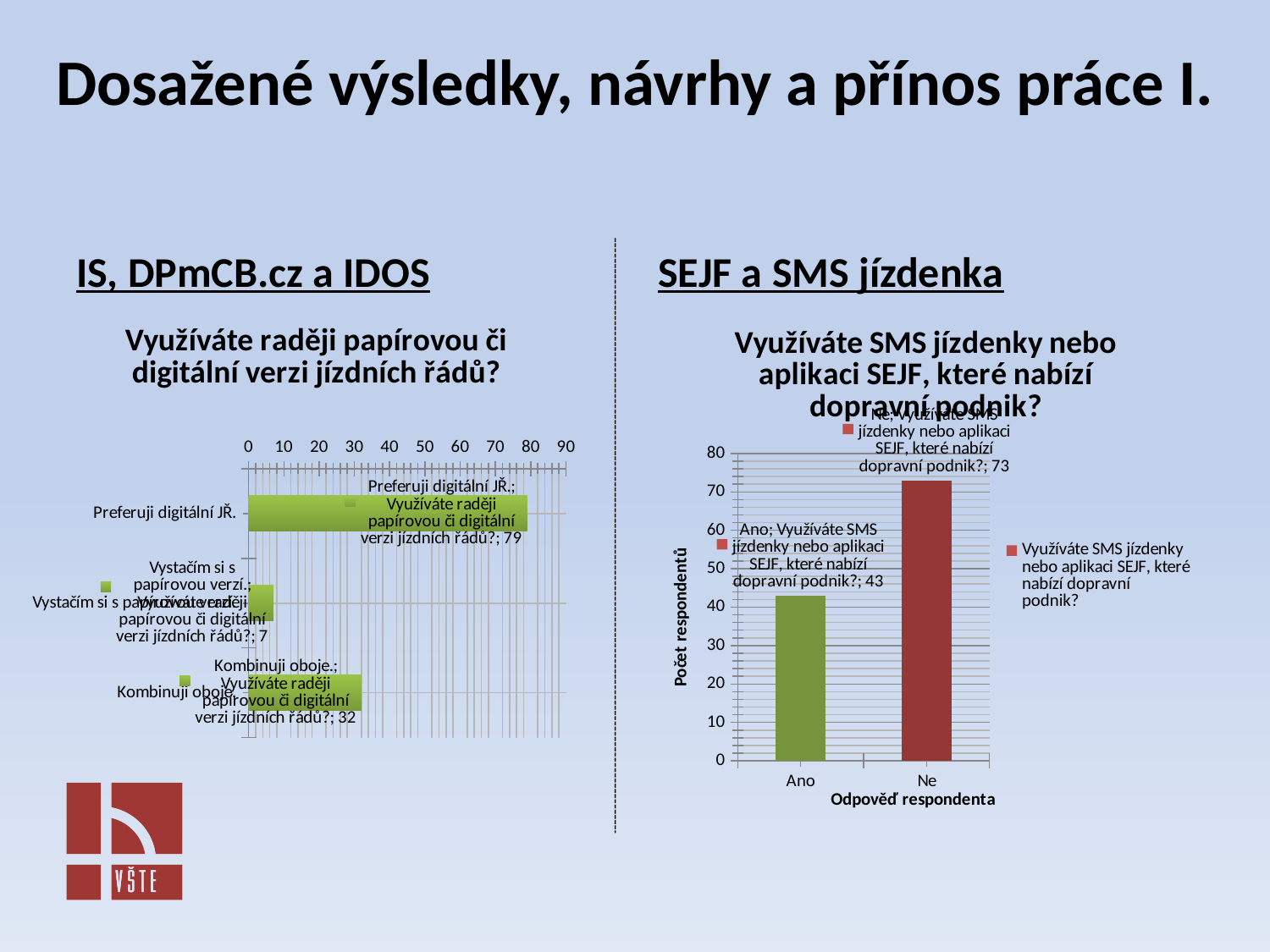
In the left chart (Využíváte raději papírovou či digitální verzi jízdních řádů?), what is the value for 'Vystačím si s papírovou verzí.'? 7 In the left chart (Využíváte raději papírovou či digitální verzi jízdních řádů?), what is the value for 'Preferuji digitální JŘ.'? 79 In the right chart (Využíváte SMS jízdenky nebo aplikaci SEJF, které nabízí dopravní podnik?), which answer has the higher value, 'Ano' or 'Ne'? Ne In the right chart (Využíváte SMS jízdenky nebo aplikaci SEJF, které nabízí dopravní podnik?), what is the value for 'Ne'? 73 In the left chart (Využíváte raději papírovou či digitální verzi jízdních řádů?), how many categories are shown? 3 In the left chart (Využíváte raději papírovou či digitální verzi jízdních řádů?), which category has the lowest value? Vystačím si s papírovou verzí. What kind of chart is the left chart (Využíváte raději papírovou či digitální verzi jízdních řádů?)? bar chart In the left chart (Využíváte raději papírovou či digitální verzi jízdních řádů?), what is the value for 'Kombinuji oboje.'? 32 In the right chart (Využíváte SMS jízdenky nebo aplikaci SEJF, které nabízí dopravní podnik?), what is the value for 'Ano'? 43 In the left chart (Využíváte raději papírovou či digitální verzi jízdních řádů?), what is the difference between 'Preferuji digitální JŘ.' and 'Kombinuji oboje.'? 47 In the right chart (Využíváte SMS jízdenky nebo aplikaci SEJF, které nabízí dopravní podnik?), what is the label of the vertical axis? Počet respondentů In the right chart (Využíváte SMS jízdenky nebo aplikaci SEJF, které nabízí dopravní podnik?), what is the difference between 'Ne' and 'Ano'? 30